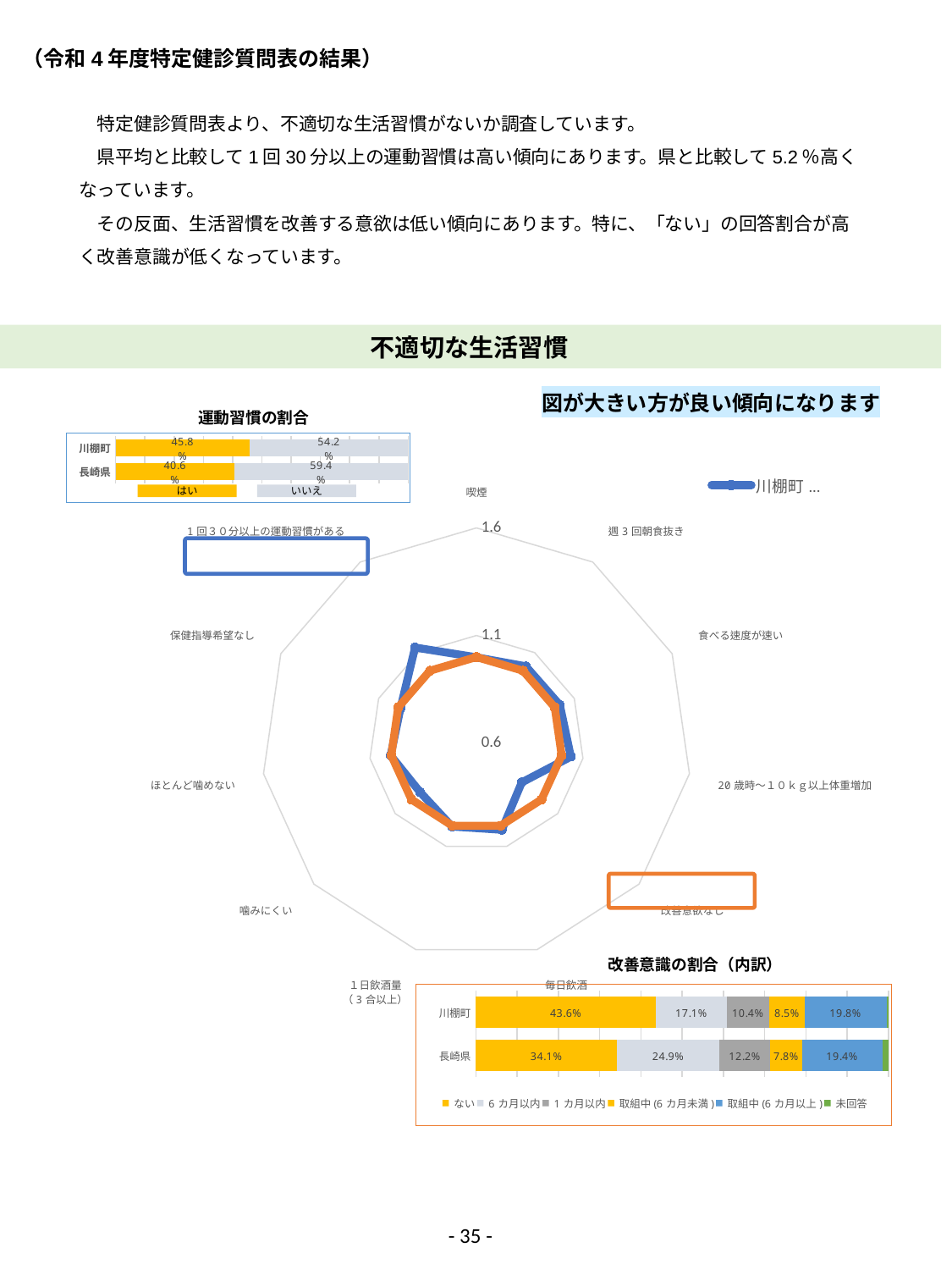
In the 改善意識の割合（内訳） chart, what is the difference between the ない values for 川棚町 and 長崎県? 9.5% What kind of chart is the large chart in the middle of the slide? Radar chart How many categories are shown around the radar chart? 11 In the 改善意識の割合（内訳） chart, how many series does the legend list? 6 In the 改善意識の割合（内訳） chart, which segment is the largest for 長崎県? ない In the 運動習慣の割合 chart, what is the difference between the はい values for 川棚町 and 長崎県? 5.2% In the 改善意識の割合（内訳） chart, what is the ない value for 川棚町? 43.6% In the 運動習慣の割合 chart, what is the いいえ value for 長崎県? 59.4% In the 運動習慣の割合 chart, what is the はい value for 川棚町? 45.8% In the 改善意識の割合（内訳） chart, what is the 取組中(6カ月以上) value for 川棚町? 19.8% In the 改善意識の割合（内訳） chart, what is the 6カ月以内 value for 長崎県? 24.9% In the 運動習慣の割合 chart, which has the larger はい value, 川棚町 or 長崎県? 川棚町